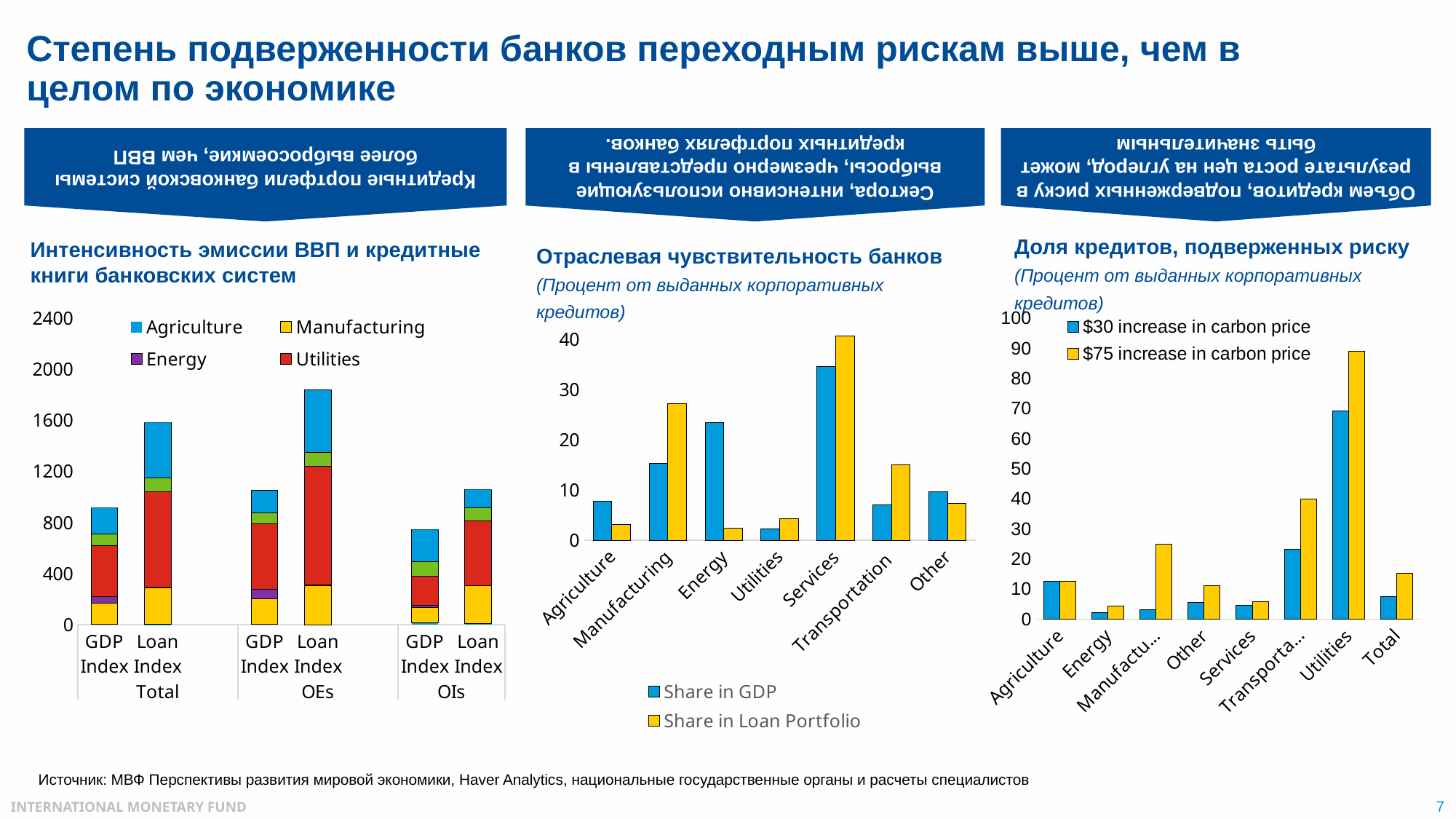
What kind of chart is the chart titled "Интенсивность эмиссии ВВП и кредитные книги банковских систем"? stacked bar chart How many series does the legend list in the chart titled "Интенсивность эмиссии ВВП и кредитные книги банковских систем"? 4 In the chart titled "Интенсивность эмиссии ВВП и кредитные книги банковских систем", which is larger: the GDP Index bar for OIs or the Loan Index bar for OIs? Loan Index In the chart titled "Доля кредитов, подверженных риску", is the value for Utilities under the $75 increase in carbon price greater or less than 80? greater In the chart titled "Интенсивность эмиссии ВВП и кредитные книги банковских систем", which bar is the tallest overall? Loan Index, OEs In the chart titled "Отраслевая чувствительность банков", which category has the lowest Share in GDP? Utilities In the chart titled "Отраслевая чувствительность банков", is the Share in Loan Portfolio for Manufacturing greater or less than 20? greater In the chart titled "Доля кредитов, подверженных риску", which category has the highest value for the $75 increase in carbon price? Utilities How many categories are shown on the x axis of the chart titled "Отраслевая чувствительность банков"? 7 In the chart titled "Доля кредитов, подверженных риску", which category has the lowest value for the $30 increase in carbon price? Energy In the chart titled "Отраслевая чувствительность банков", which category has the highest Share in GDP? Services In the chart titled "Интенсивность эмиссии ВВП и кредитные книги банковских систем", is the total for the Loan Index under Total greater or less than 1200? greater